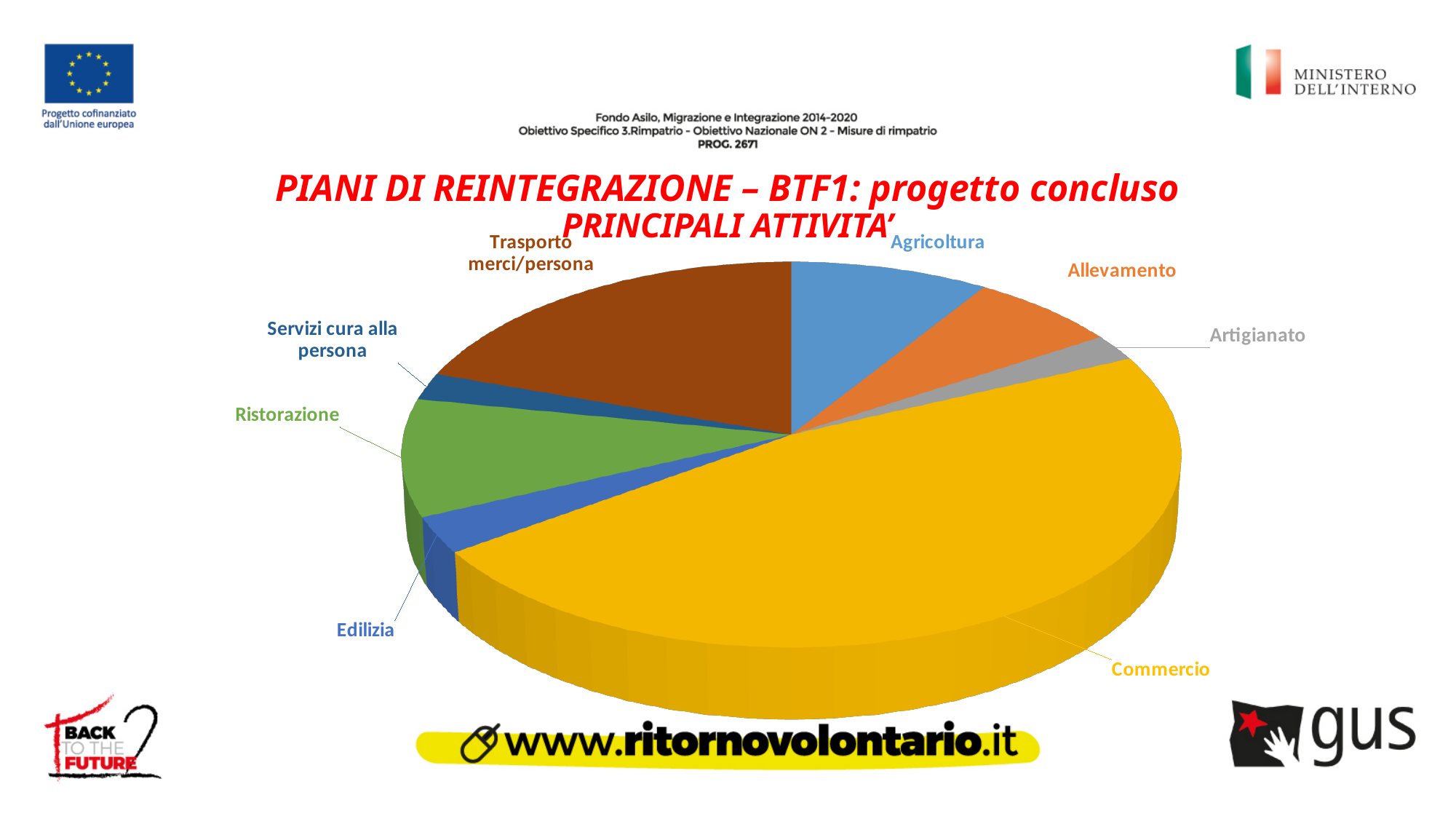
Which category has the second largest slice of the pie chart? Trasporto merci/persona Which category has the largest slice of the pie chart? Commercio Which slice is larger, Trasporto merci/persona or Agricoltura? Trasporto merci/persona Which slice is larger, Ristorazione or Artigianato? Ristorazione What kind of chart is shown on the slide? Pie chart Which slice is larger, Commercio or Trasporto merci/persona? Commercio What is the subtitle of the chart, shown below the red title? PRINCIPALI ATTIVITA' What colour is the Commercio slice of the pie chart? Yellow How many categories (slices) does the pie chart show? 8